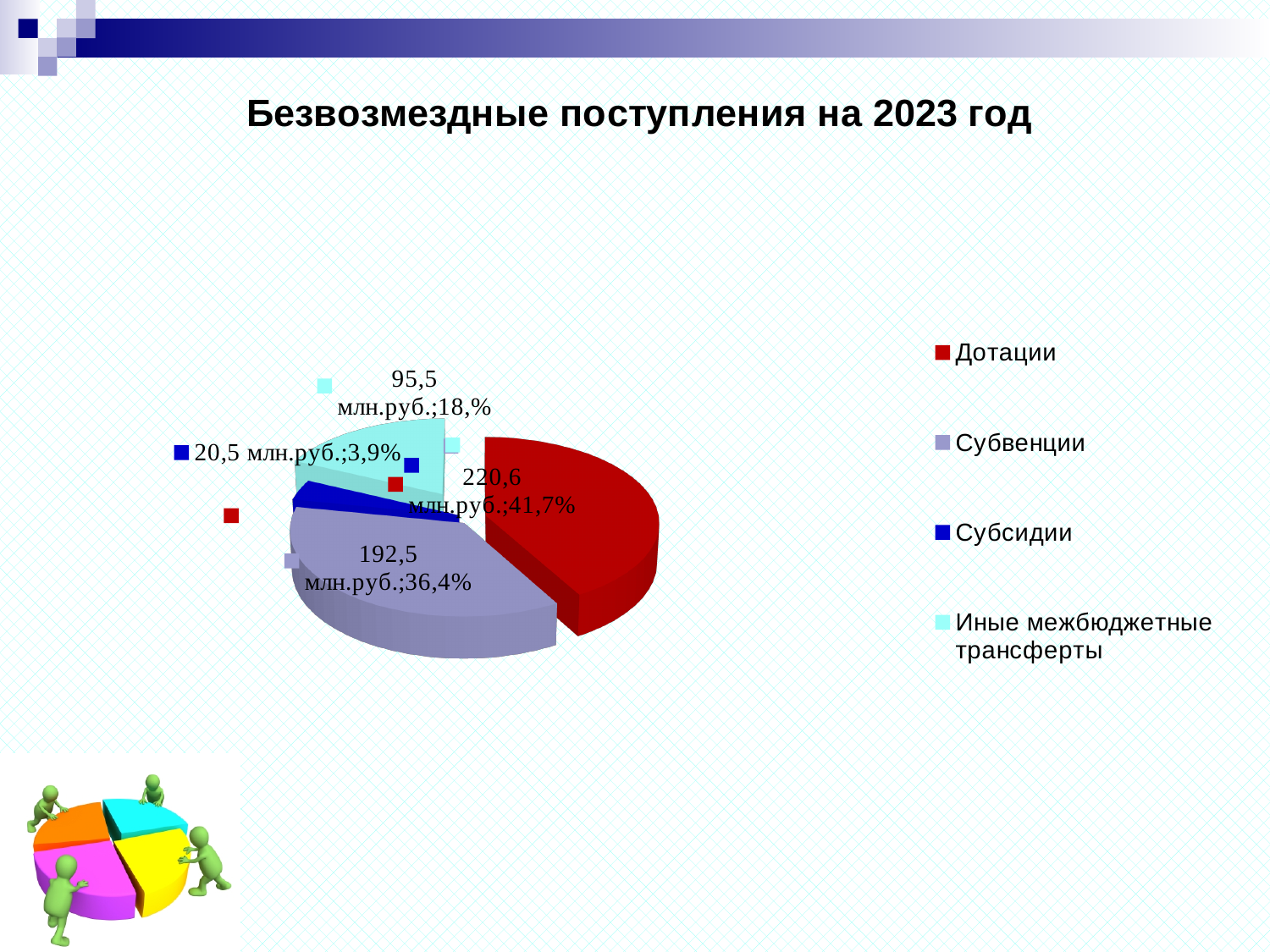
What is the value for Субвенции? 192,5 млн.руб. What kind of chart is shown on the slide? pie chart What share of the pie does Субвенции represent? 36,4% What is the difference between the values for Дотации and Субвенции? 28,1 млн.руб. How many slices does the pie chart have? 4 What is the value for Иные межбюджетные трансферты? 95,5 млн.руб. What is the value for Субсидии? 20,5 млн.руб. Which category has the largest share of the pie? Дотации What share of the pie does Дотации represent? 41,7% What is the value for Дотации? 220,6 млн.руб. Which category has the smallest share of the pie? Субсидии Which colour represents Субсидии in the legend? blue